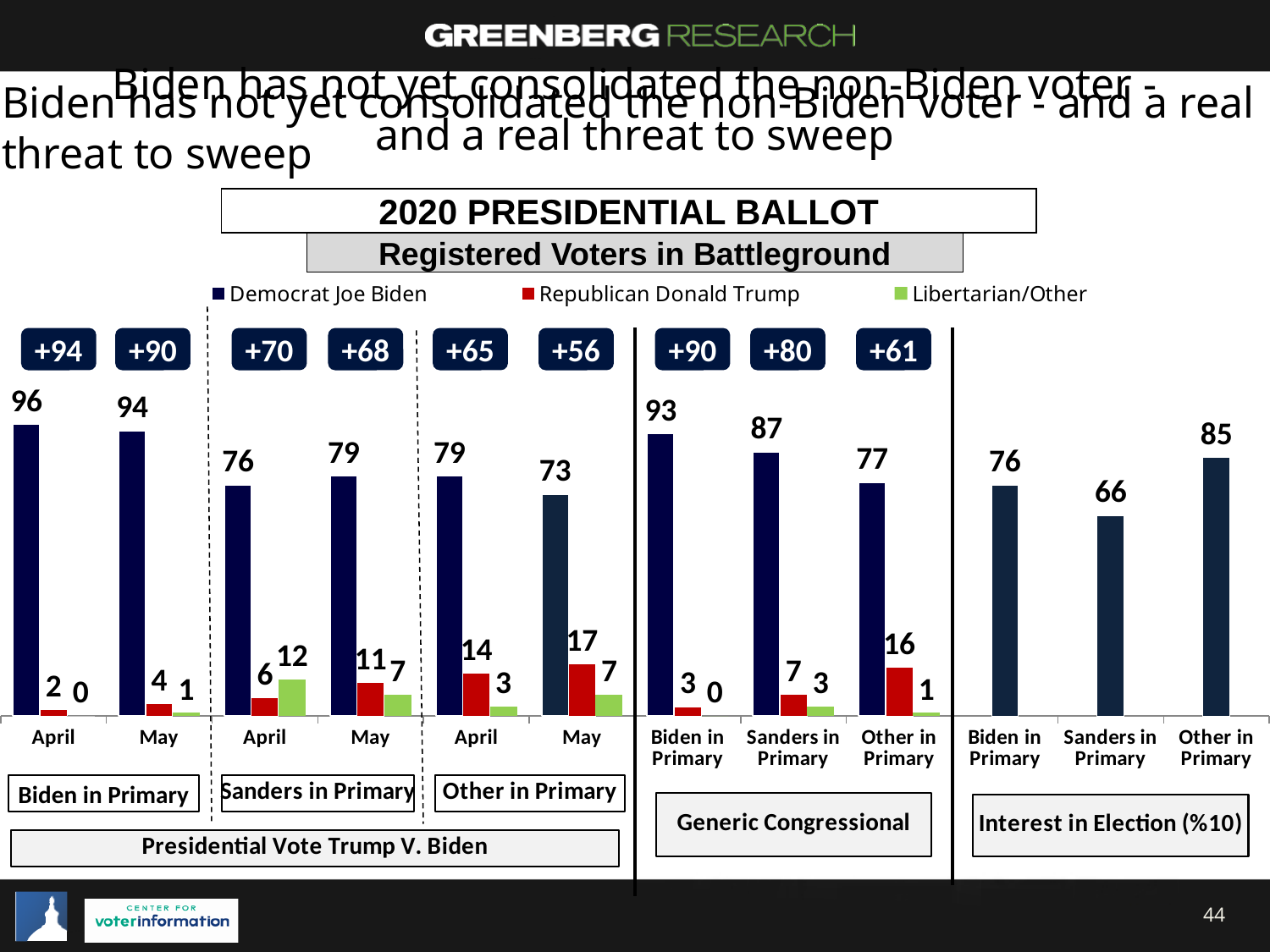
How many series does the legend list? 3 In the Presidential Vote Trump V. Biden section, what is the value for Democrat Joe Biden among Biden in Primary voters in April? 96 In the Generic Congressional section, what is the margin label shown above the Other in Primary bars? +61 In the Presidential Vote Trump V. Biden section, by how much did the Democrat Joe Biden value for Sanders in Primary voters change from April to May? 3 In the Presidential Vote Trump V. Biden section, does the Democrat Joe Biden value for Other in Primary voters rise or fall from April to May? Fall In the Interest in Election (%10) section, which group has the lowest value? Sanders in Primary In the Interest in Election (%10) section, what is the value for Other in Primary? 85 In the Interest in Election (%10) section, which group has the highest value? Other in Primary In the Presidential Vote Trump V. Biden section, what is the value for Republican Donald Trump among Other in Primary voters in May? 17 What kind of chart is shown on the slide? Bar chart In the Generic Congressional section, which has the larger Democrat value: Sanders in Primary or Other in Primary? Sanders in Primary In the Presidential Vote Trump V. Biden section, what is the Libertarian/Other value for Sanders in Primary voters in April? 12